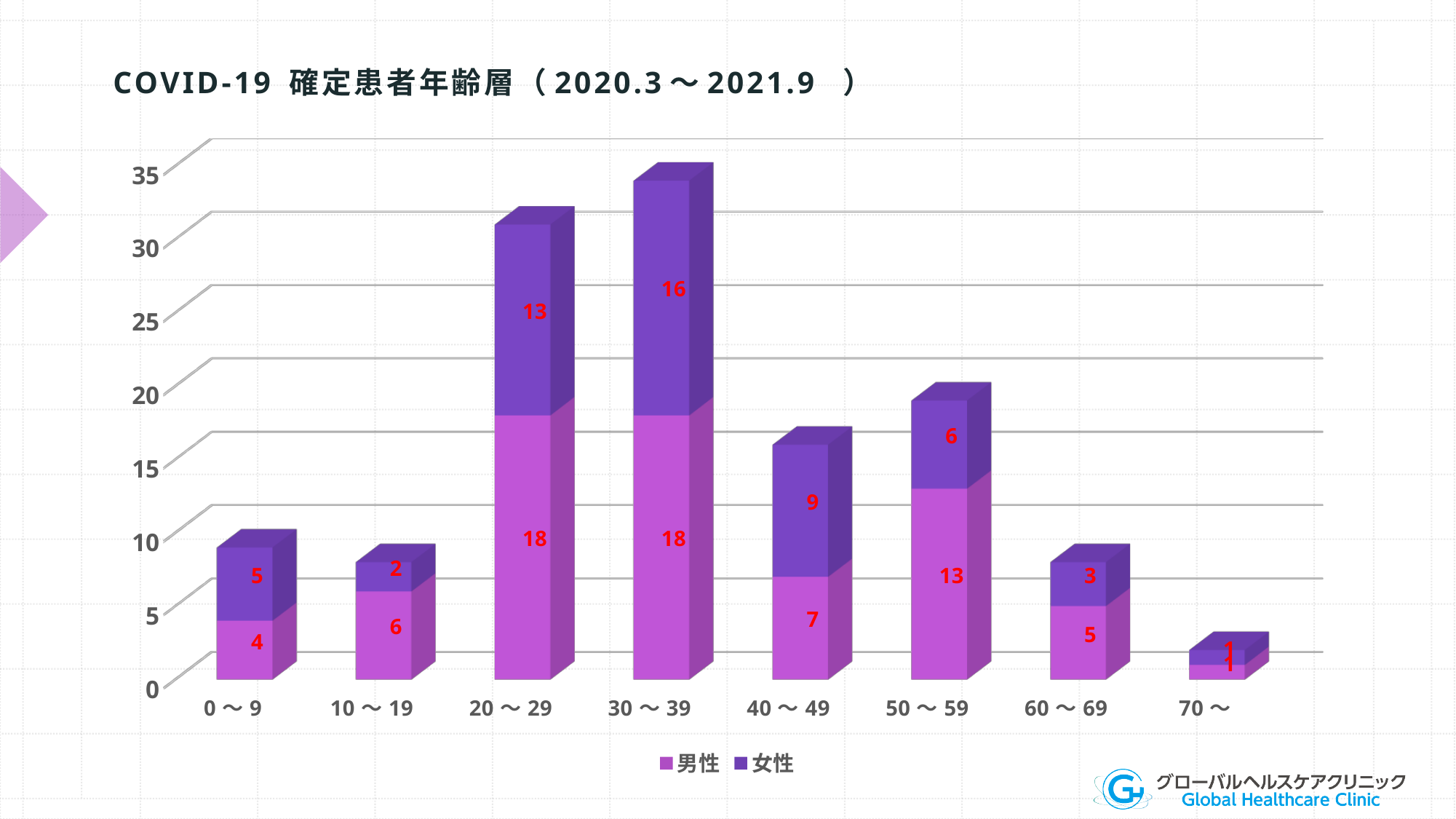
What is the total of the stacked bar for the 50～59 age group? 19 What is the 男性 value for the 30～39 age group? 18 What kind of chart is shown on the slide? Stacked bar chart Which age group has the highest 女性 value? 30～39 Which is larger for the 40～49 age group, the 男性 value or the 女性 value? 女性 How many age groups are shown on the x axis? 8 Which age group has the lowest 男性 value? 70～ What is the 女性 value for the 40～49 age group? 9 What is the difference between the 男性 and 女性 values for the 50～59 age group? 7 How many series does the legend list? 2 What is the 女性 value for the 20～29 age group? 13 What is the total of the stacked bar for the 30～39 age group? 34